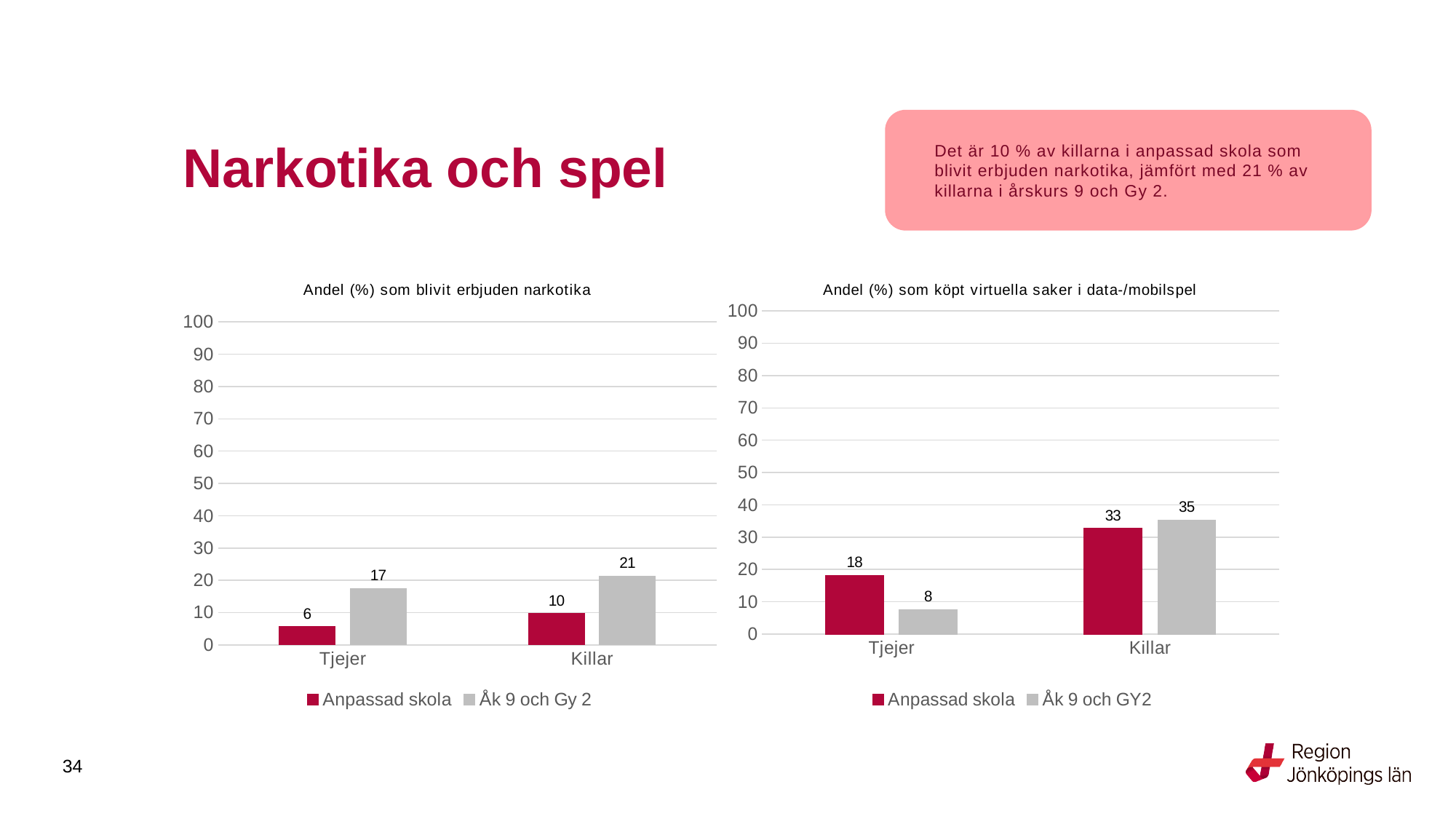
In the chart 'Andel (%) som blivit erbjuden narkotika', what is the value for Tjejer in Åk 9 och Gy 2? 17 How many series does the legend of the chart 'Andel (%) som blivit erbjuden narkotika' list? 2 In the chart 'Andel (%) som köpt virtuella saker i data-/mobilspel', what is the value for Killar in Åk 9 och GY2? 35 What kind of chart is 'Andel (%) som blivit erbjuden narkotika'? Bar chart In the chart 'Andel (%) som köpt virtuella saker i data-/mobilspel', what is the difference between Anpassad skola and Åk 9 och GY2 for Tjejer? 10 How many categories are shown on the x axis of the chart 'Andel (%) som köpt virtuella saker i data-/mobilspel'? 2 In the chart 'Andel (%) som köpt virtuella saker i data-/mobilspel', which bar has the highest value? Killar, Åk 9 och GY2 In the chart 'Andel (%) som blivit erbjuden narkotika', which bar has the lowest value? Tjejer, Anpassad skola In the chart 'Andel (%) som köpt virtuella saker i data-/mobilspel', what is the value for Tjejer in Anpassad skola? 18 In the chart 'Andel (%) som blivit erbjuden narkotika', what is the difference between the Åk 9 och Gy 2 value and the Anpassad skola value for Killar? 11 In the chart 'Andel (%) som köpt virtuella saker i data-/mobilspel', which is larger for Tjejer: Anpassad skola or Åk 9 och GY2? Anpassad skola In the chart 'Andel (%) som blivit erbjuden narkotika', what is the value for Killar in Anpassad skola? 10